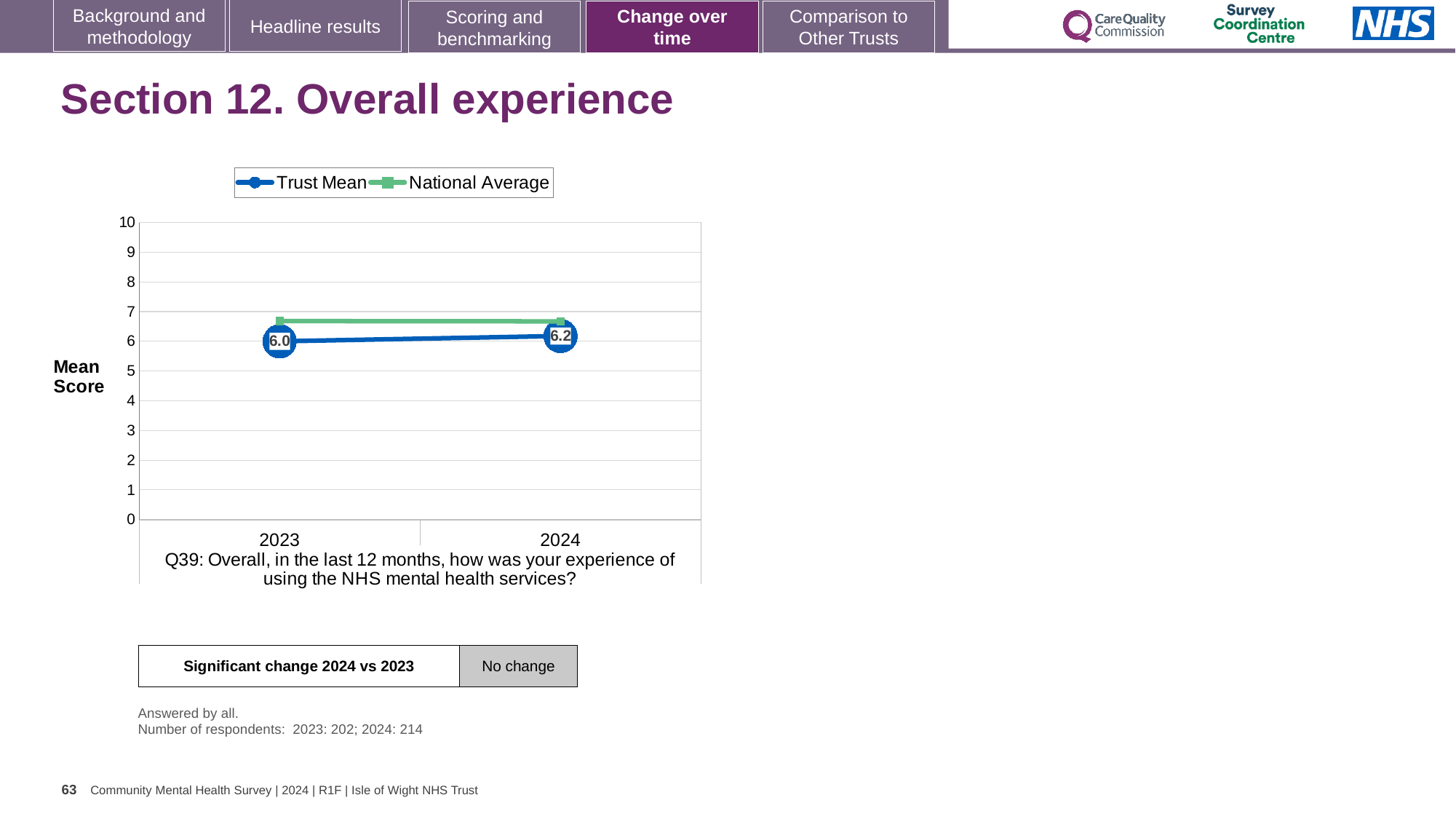
Does the Trust Mean rise or fall from 2023 to 2024? rise How many series does the legend list? 2 Which year has the higher Trust Mean, 2023 or 2024? 2024 What is the difference between the Trust Mean in 2024 and in 2023? 0.2 What is the Trust Mean value for 2024? 6.2 Is the National Average value for 2024 greater or less than 7? less How many years are plotted on the x axis? 2 Is the National Average value for 2023 greater or less than 6? greater What is the Trust Mean value for 2023? 6.0 What kind of chart is shown on the slide? line chart What is the label on the y axis of the chart? Mean Score In 2024, which is higher, the Trust Mean or the National Average? National Average